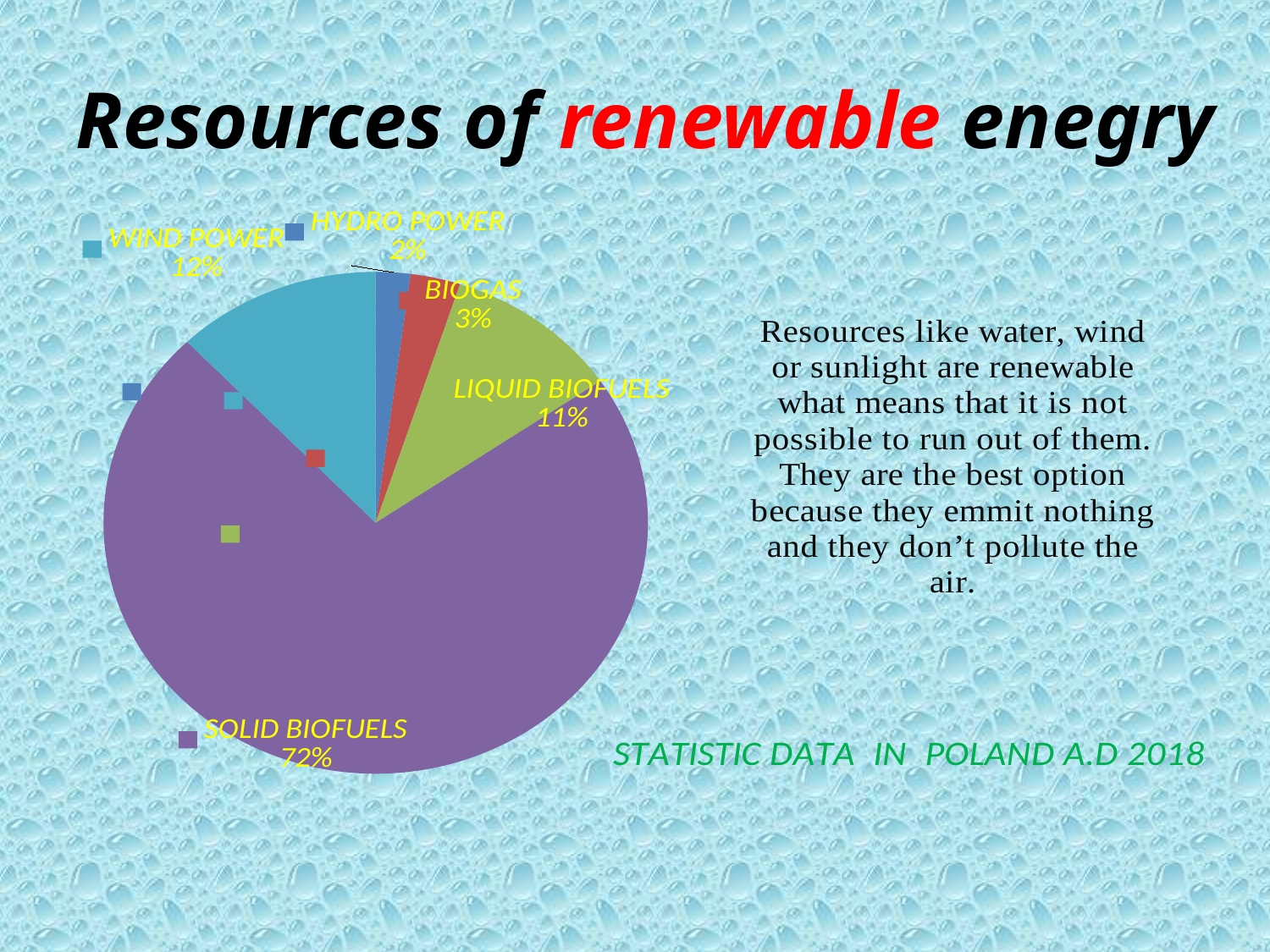
What colour is the SOLID BIOFUELS slice? purple How many categories are shown in the pie chart? 5 What share of the pie does WIND POWER have? 12% Which category has the smallest slice of the pie? HYDRO POWER What is the difference in percentage points between SOLID BIOFUELS and WIND POWER? 60 Which is larger, the share for WIND POWER or the share for LIQUID BIOFUELS? WIND POWER What share of the pie does LIQUID BIOFUELS have? 11% What share of the pie does SOLID BIOFUELS have? 72% What kind of chart is shown on the slide? pie chart Which category has the largest slice of the pie? SOLID BIOFUELS